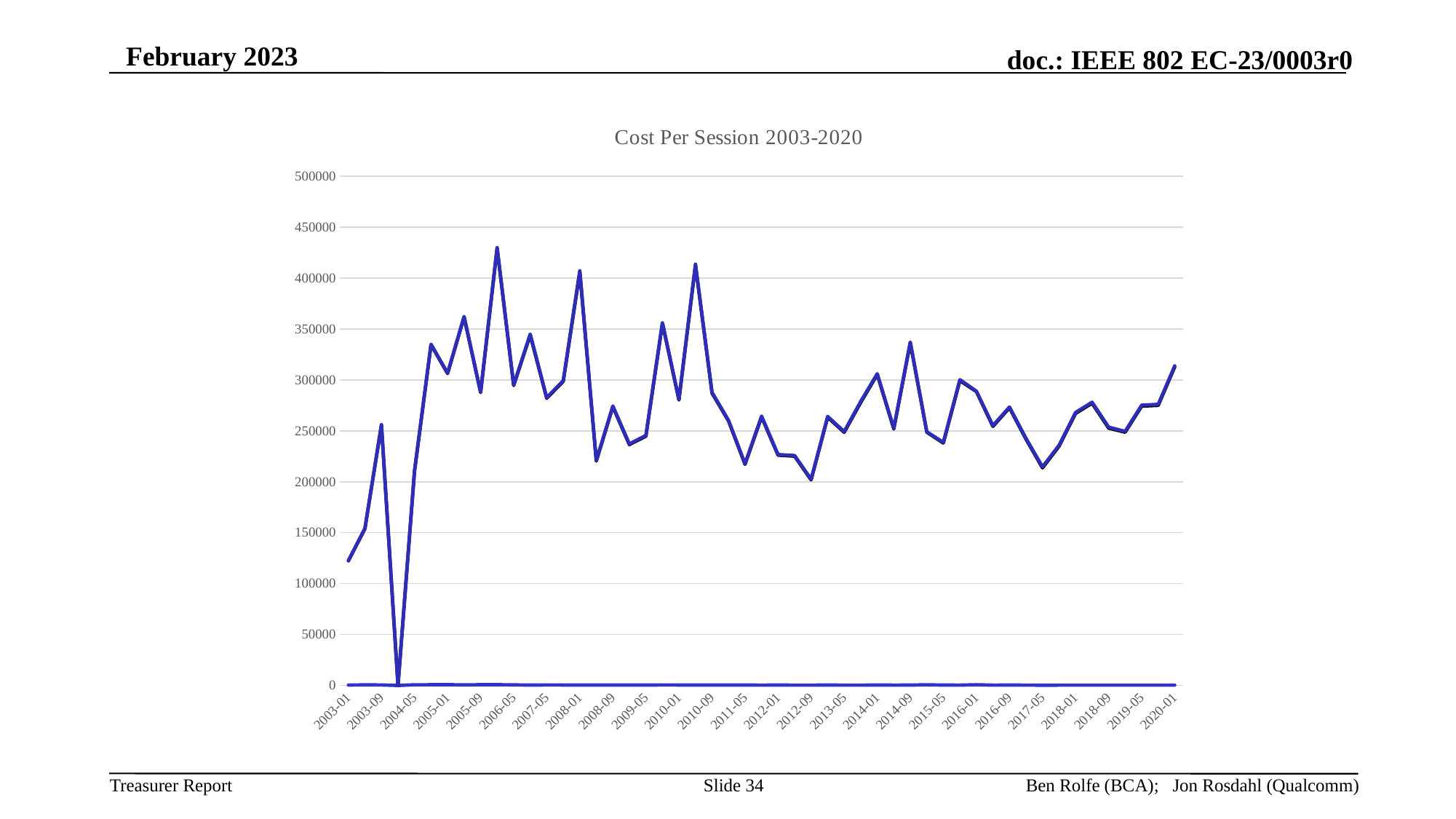
Is the value for 2014-09 greater or less than 300000? greater What is the title of the chart? Cost Per Session 2003-2020 What is the highest value shown on the vertical axis? 500000 Is the value for 2017-05 greater or less than 250000? less Is the value for 2012-09 greater or less than 250000? less Which has the higher cost per session, 2014-09 or 2017-05? 2014-09 What kind of chart is shown on the slide? Line chart Which has the higher cost per session, 2003-01 or 2020-01? 2020-01